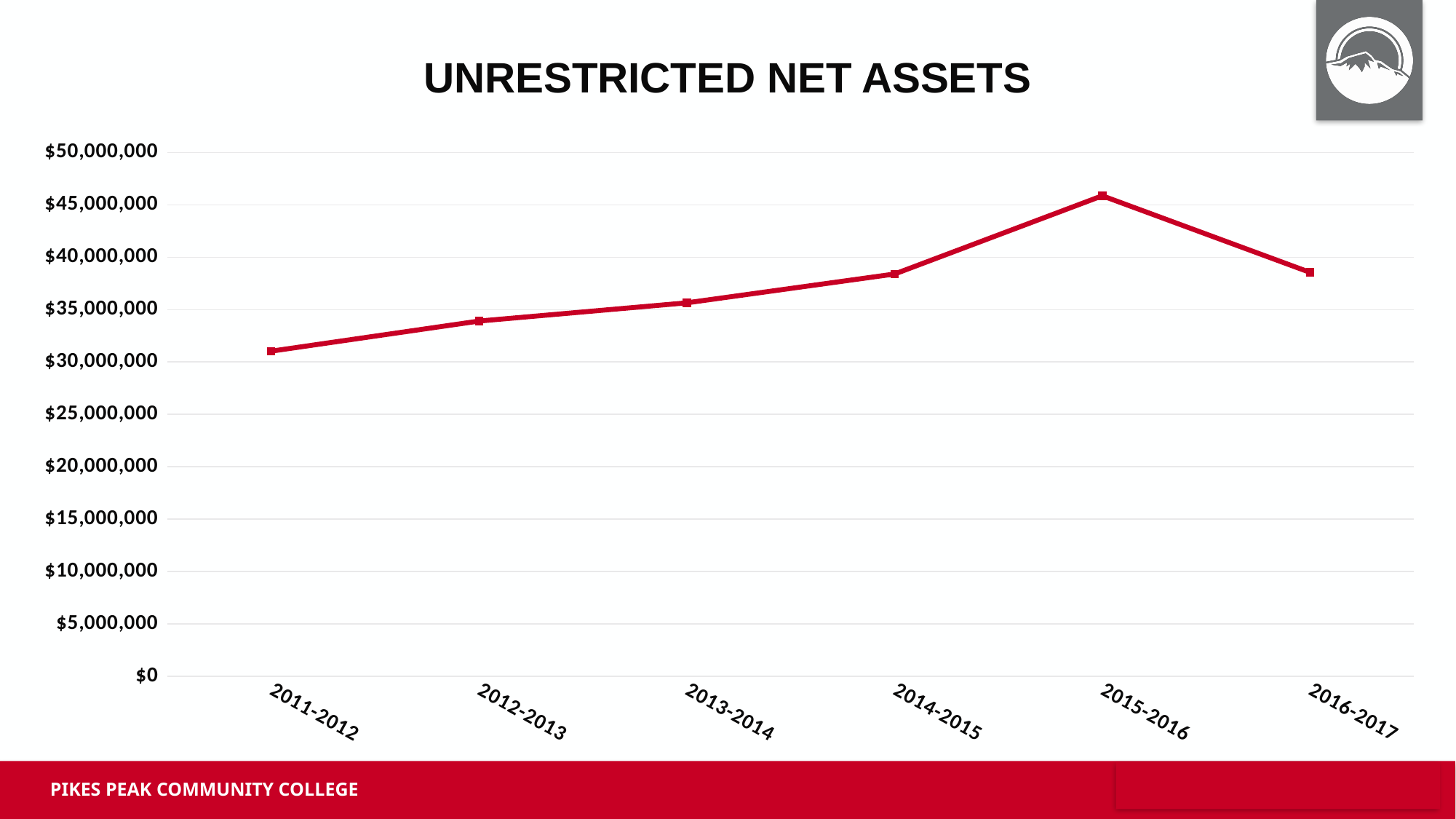
Is the value for 2012-2013 greater or less than $35,000,000? less Which fiscal year has the lowest unrestricted net assets? 2011-2012 Do the values rise or fall from 2011-2012 to 2015-2016? rise Which is larger, the value for 2011-2012 or the value for 2012-2013? 2012-2013 What kind of chart is shown on the slide? Line chart What is the title of the chart? UNRESTRICTED NET ASSETS Is the value for 2015-2016 greater or less than $45,000,000? greater Which fiscal year has the highest unrestricted net assets? 2015-2016 How many fiscal years are plotted on the x axis? 6 Which is larger, the value for 2015-2016 or the value for 2016-2017? 2015-2016 Is the value for 2014-2015 greater or less than $40,000,000? less